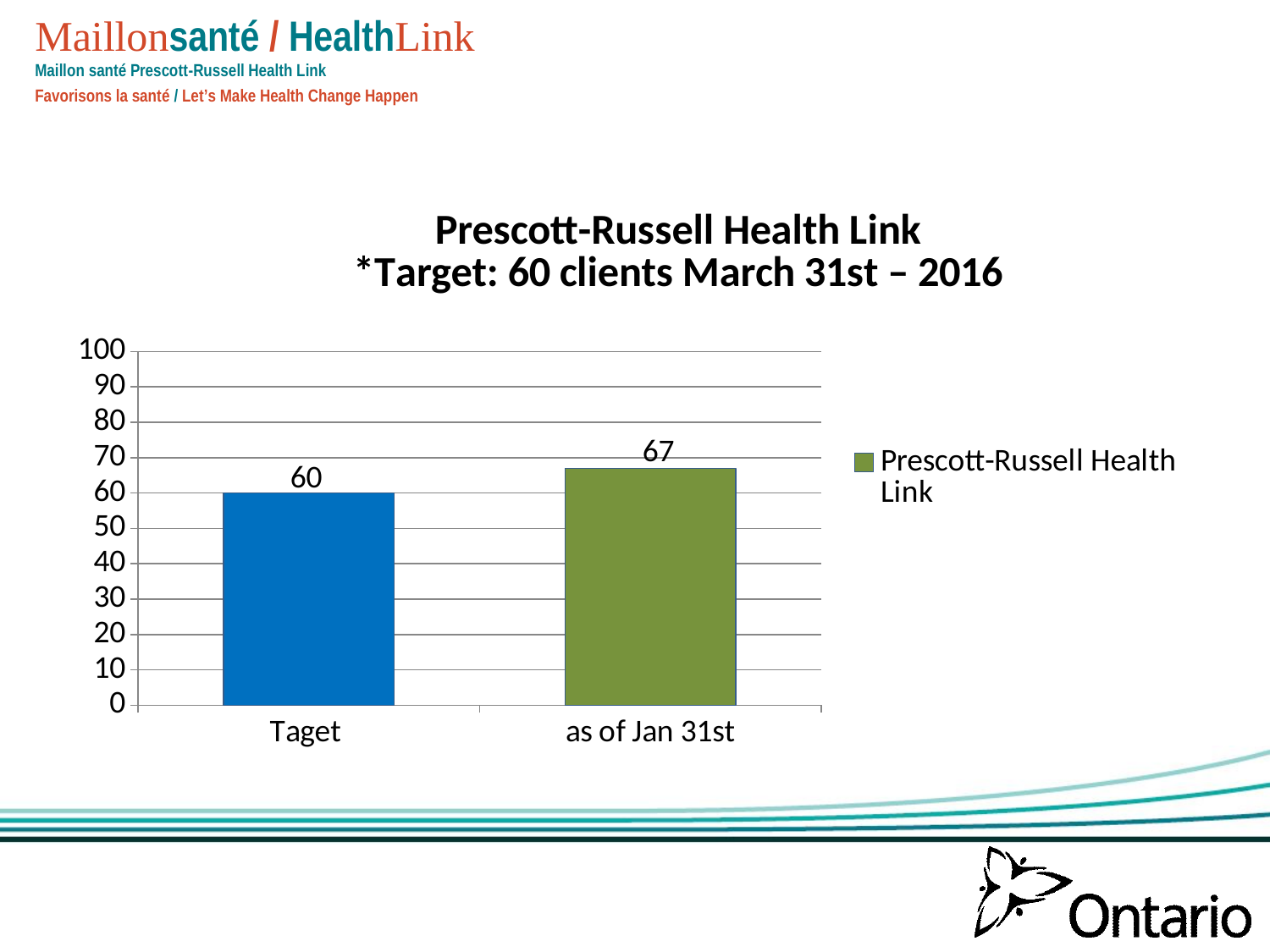
Which category has the lowest value? Taget Is the value for as of Jan 31st greater or less than 70? less Do the values rise or fall from Taget to as of Jan 31st? rise Which category has the highest value? as of Jan 31st What is the value for as of Jan 31st? 67 What is the legend entry for the chart? Prescott-Russell Health Link How many categories are shown on the x axis? 2 Which is larger, the value for Taget or the value for as of Jan 31st? as of Jan 31st What is the value for Taget? 60 What kind of chart is shown on the slide? bar chart What is the difference between the value for as of Jan 31st and the value for Taget? 7 How many series does the legend list? 1